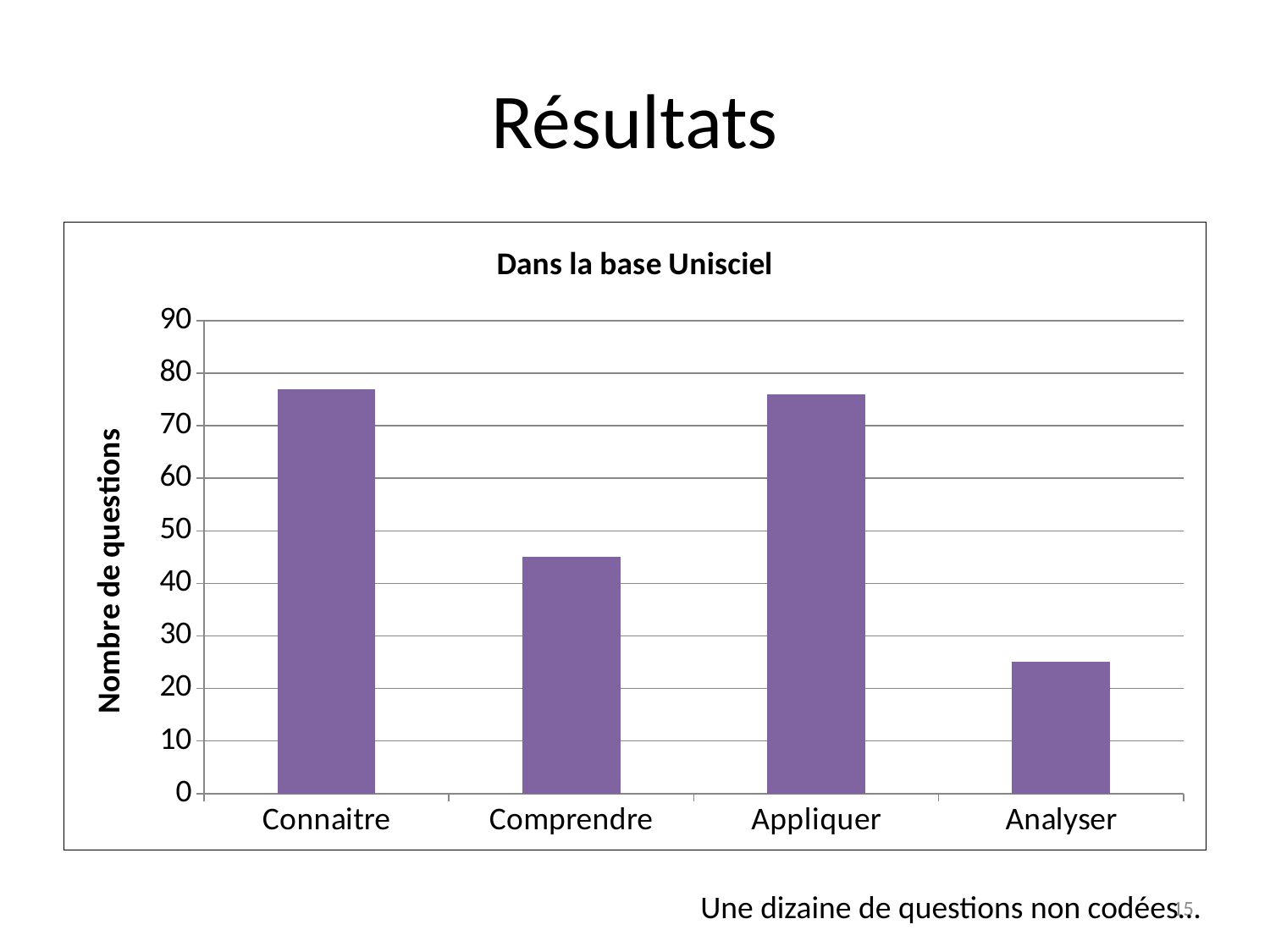
Is the value for Connaitre greater or less than 70? greater What is the title of the chart? Dans la base Unisciel Is the value for Comprendre greater or less than 50? less Which has more questions, Comprendre or Analyser? Comprendre Is the value for Analyser greater or less than 30? less How many categories are shown on the x axis? 4 Which category has the lowest number of questions? Analyser Which has more questions, Connaitre or Comprendre? Connaitre What is the label of the vertical axis? Nombre de questions What kind of chart is shown on the slide? bar chart